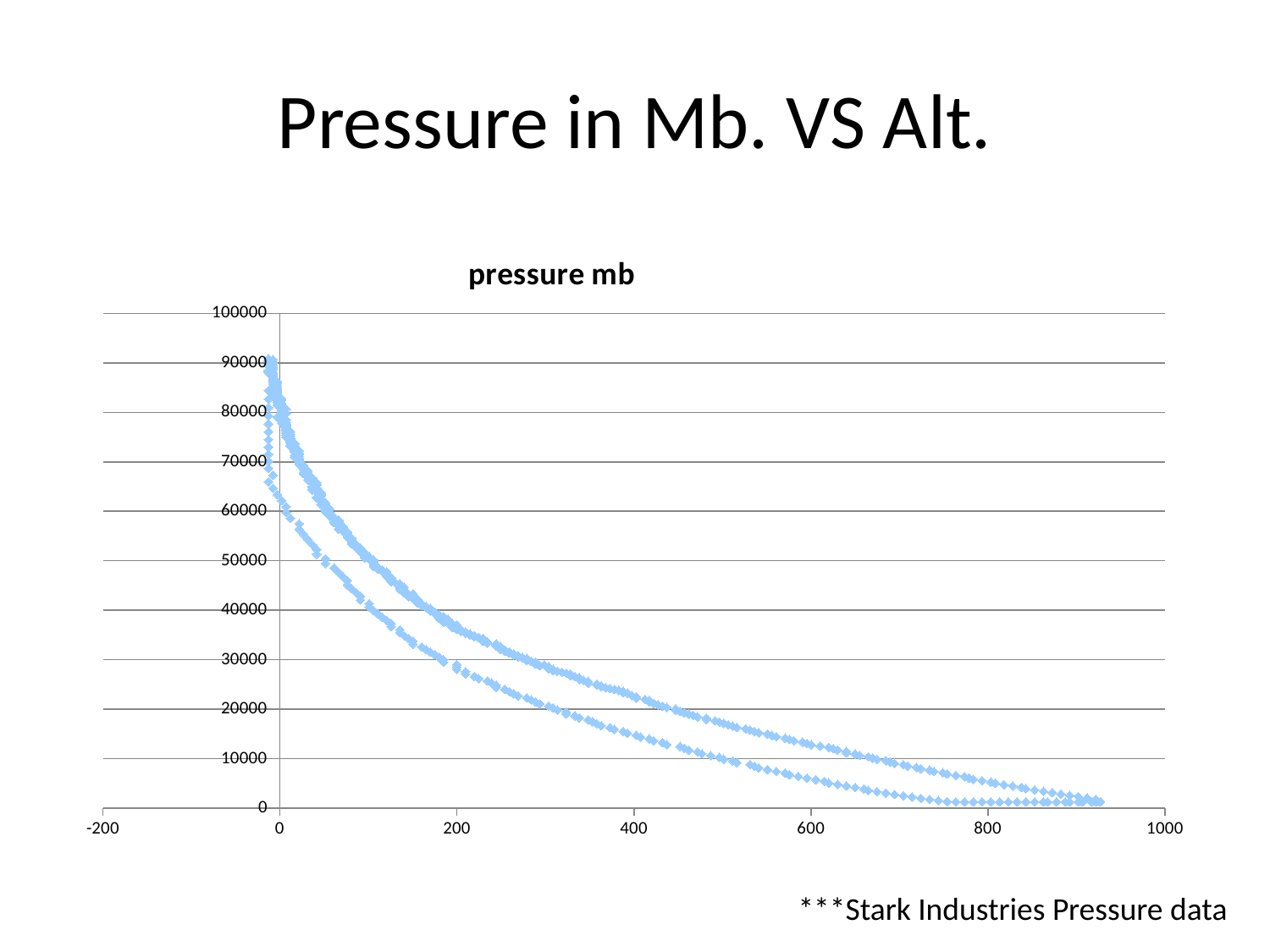
Are the plotted values at x = 200 greater or less than 60000? less Are the plotted values at x = 400 greater or less than 40000? less What kind of chart is shown on the slide? scatter chart Are the plotted values at x = 0 greater or less than 50000? greater What is the title of the chart? pressure mb Do the plotted values rise or fall as the x-axis value increases? fall What is the highest value shown on the vertical axis? 100000